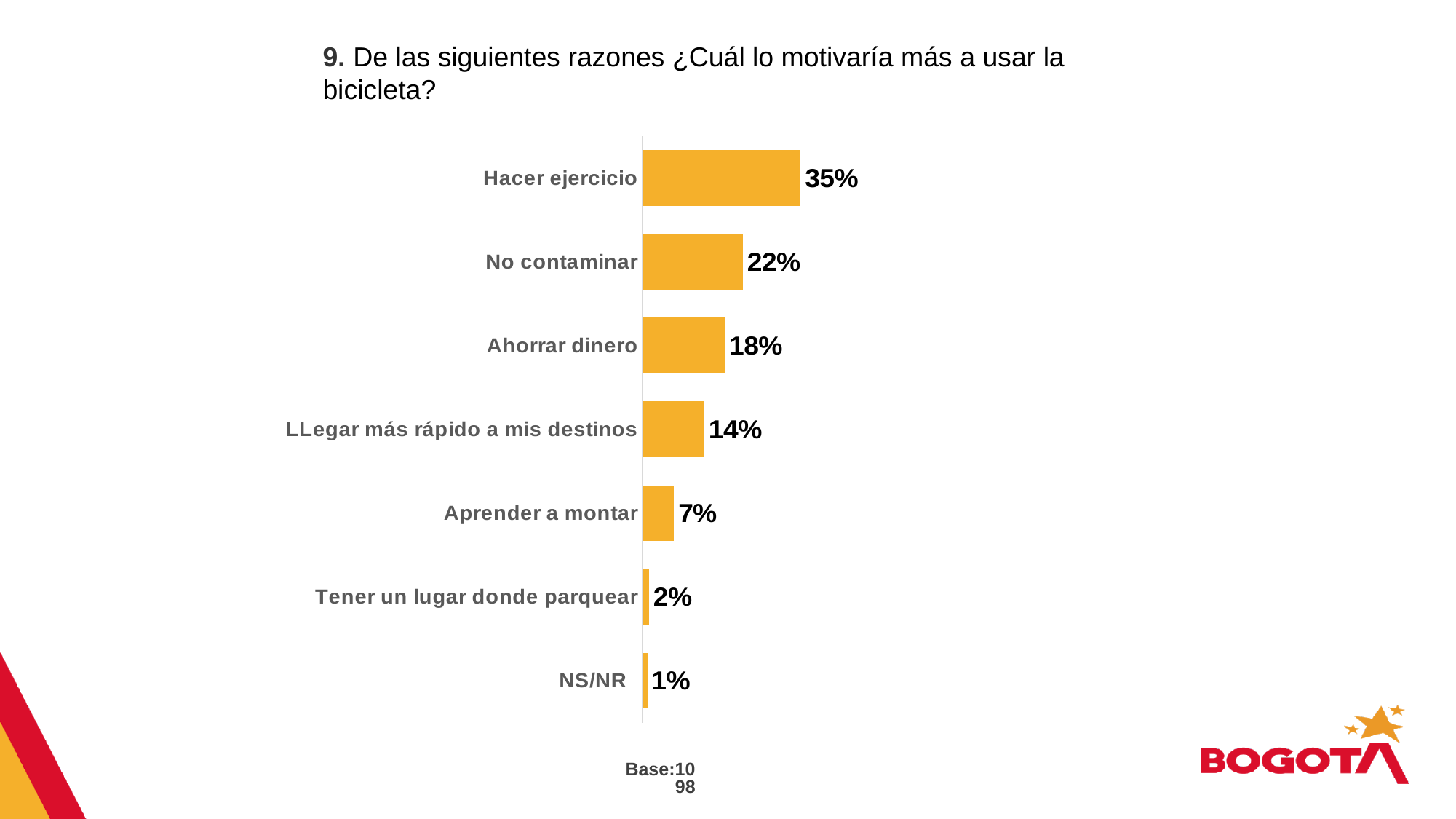
What is the difference in percentage points between "Hacer ejercicio" and "No contaminar"? 13 What is the value shown for "No contaminar"? 22% What percentage is shown for "Aprender a montar"? 7% Which has a higher percentage: "Ahorrar dinero" or "Aprender a montar"? Ahorrar dinero What is the value for "Tener un lugar donde parquear"? 2% What is the difference in percentage points between "Ahorrar dinero" and "LLegar más rápido a mis destinos"? 4 Which category has the lowest percentage in the chart? NS/NR What percentage of respondents chose "Hacer ejercicio" as the reason that would most motivate them to use a bicycle? 35% What is the base (number of respondents) indicated below the chart? 1098 Which reason has the highest percentage in the chart? Hacer ejercicio How many categories (reasons) are shown in the chart? 7 What type of chart is shown on the slide? Bar chart